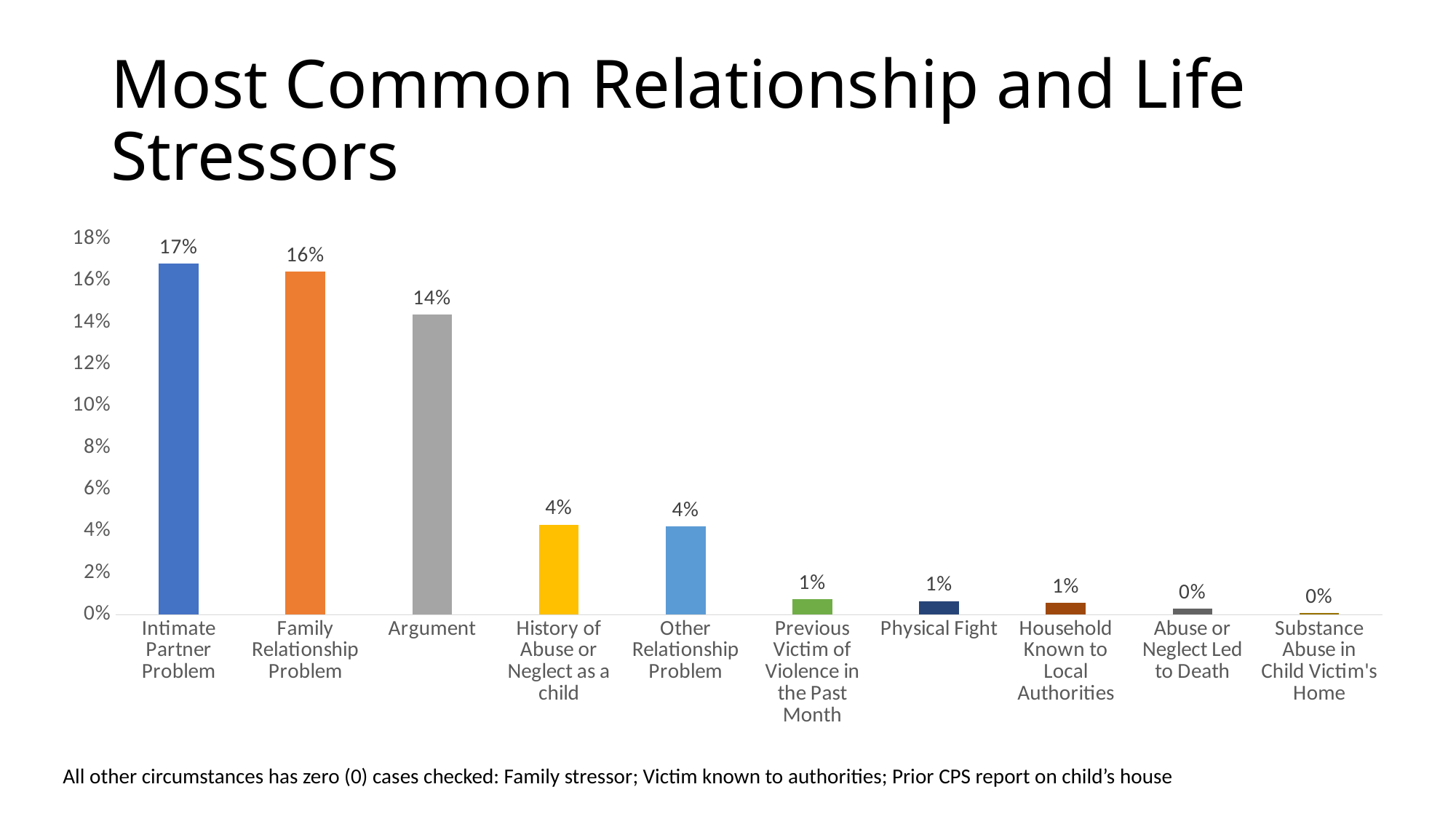
What is the value for Intimate Partner Problem? 17% Do the values rise or fall from left to right across the categories? fall What kind of chart is shown on the slide? bar chart Is the value for Argument greater or less than 10%? greater What is the value for Argument? 14% What is the value for Physical Fight? 1% Which is larger, the value for Argument or the value for History of Abuse or Neglect as a child? Argument What is the value for Substance Abuse in Child Victim's Home? 0% Which category has the highest value? Intimate Partner Problem What is the difference between the values for Intimate Partner Problem and Argument? 3% What is the value for Family Relationship Problem? 16% How many categories are shown in the chart? 10